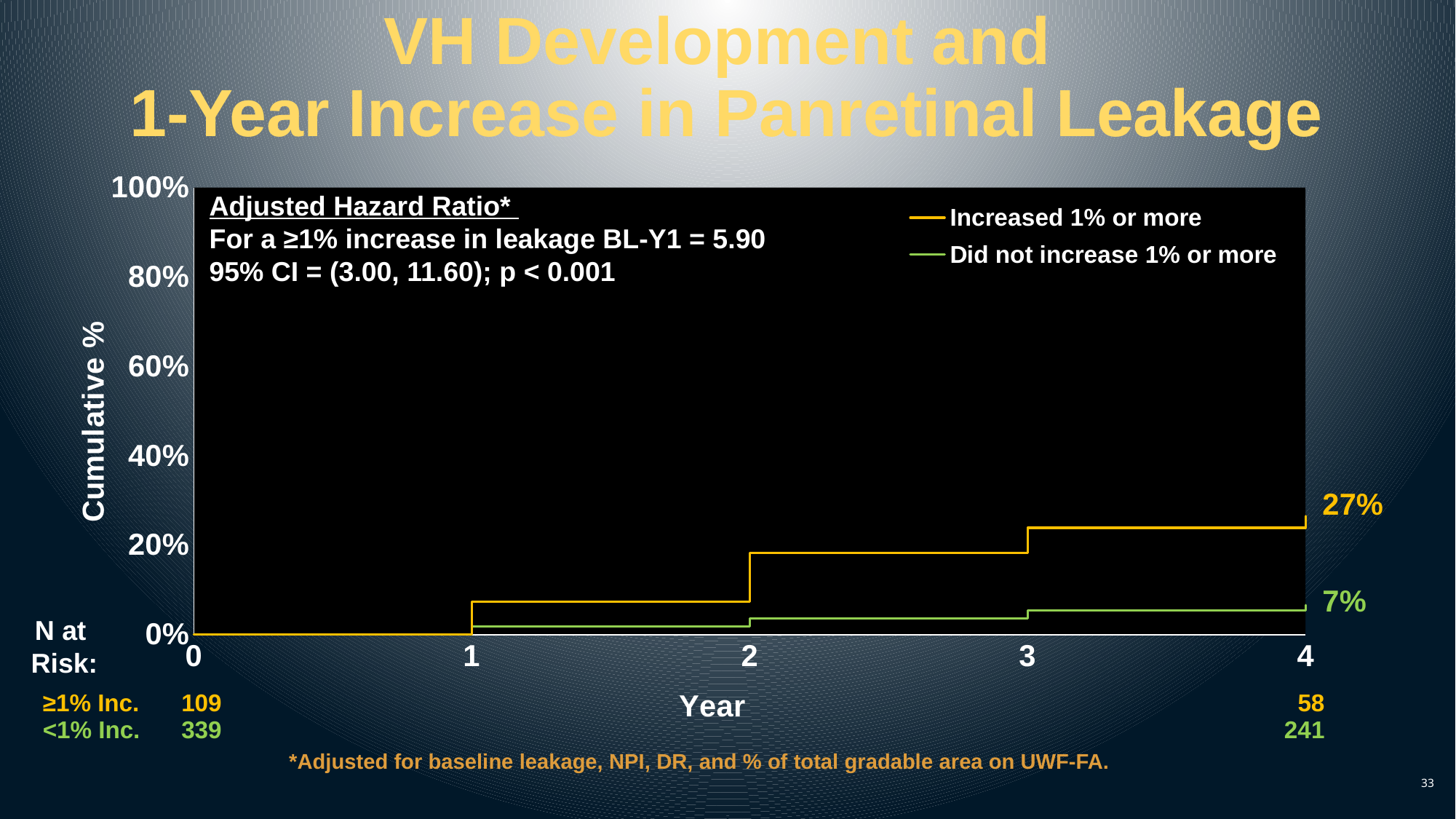
What is the adjusted hazard ratio for a ≥1% increase in leakage BL-Y1 shown on the chart? 5.90 What is the cumulative % at year 4 for the 'Increased 1% or more' group? 27% Is the cumulative % for the 'Increased 1% or more' group at year 2 greater or less than 20%? less What is the number at risk at year 0 for the ≥1% Inc. group? 109 Is the cumulative % for the 'Increased 1% or more' group at year 4 greater or less than 20%? greater What is the difference between the year-4 cumulative % of the 'Increased 1% or more' group and the 'Did not increase 1% or more' group? 20% How many series does the legend list? 2 What is the cumulative % at year 4 for the 'Did not increase 1% or more' group? 7% What kind of chart is shown on the slide? Line chart (step / cumulative incidence curve) Which group has the higher cumulative % at year 4? Increased 1% or more What is the number at risk at year 4 for the <1% Inc. group? 241 Do the cumulative % values rise or fall as Year increases? rise